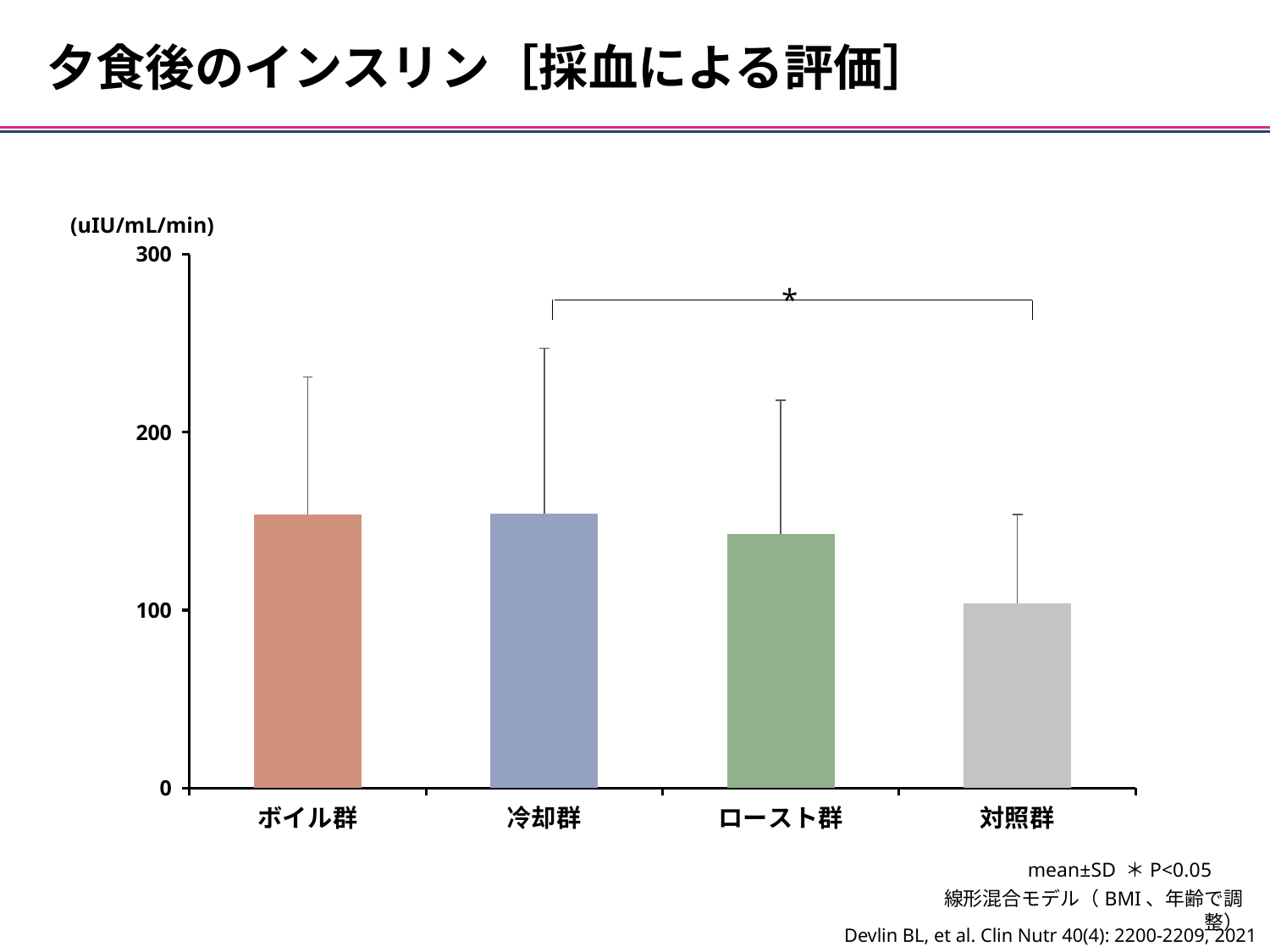
Which group has the lowest postprandial insulin value? 対照群 Which is larger, the value for ロースト群 or the value for 対照群? ロースト群 Which is larger, the value for 冷却群 or the value for 対照群? 冷却群 Is the value for ロースト群 greater or less than 100? greater Is the value for 冷却群 greater or less than 200? less Is the value for ボイル群 greater or less than 200? less What unit is shown for the y axis of the chart? (uIU/mL/min) How many groups (categories) are plotted on the x axis? 4 What kind of chart is shown on the slide? bar chart Between which two groups is the significance marker (＊) drawn on the chart? 冷却群 and 対照群